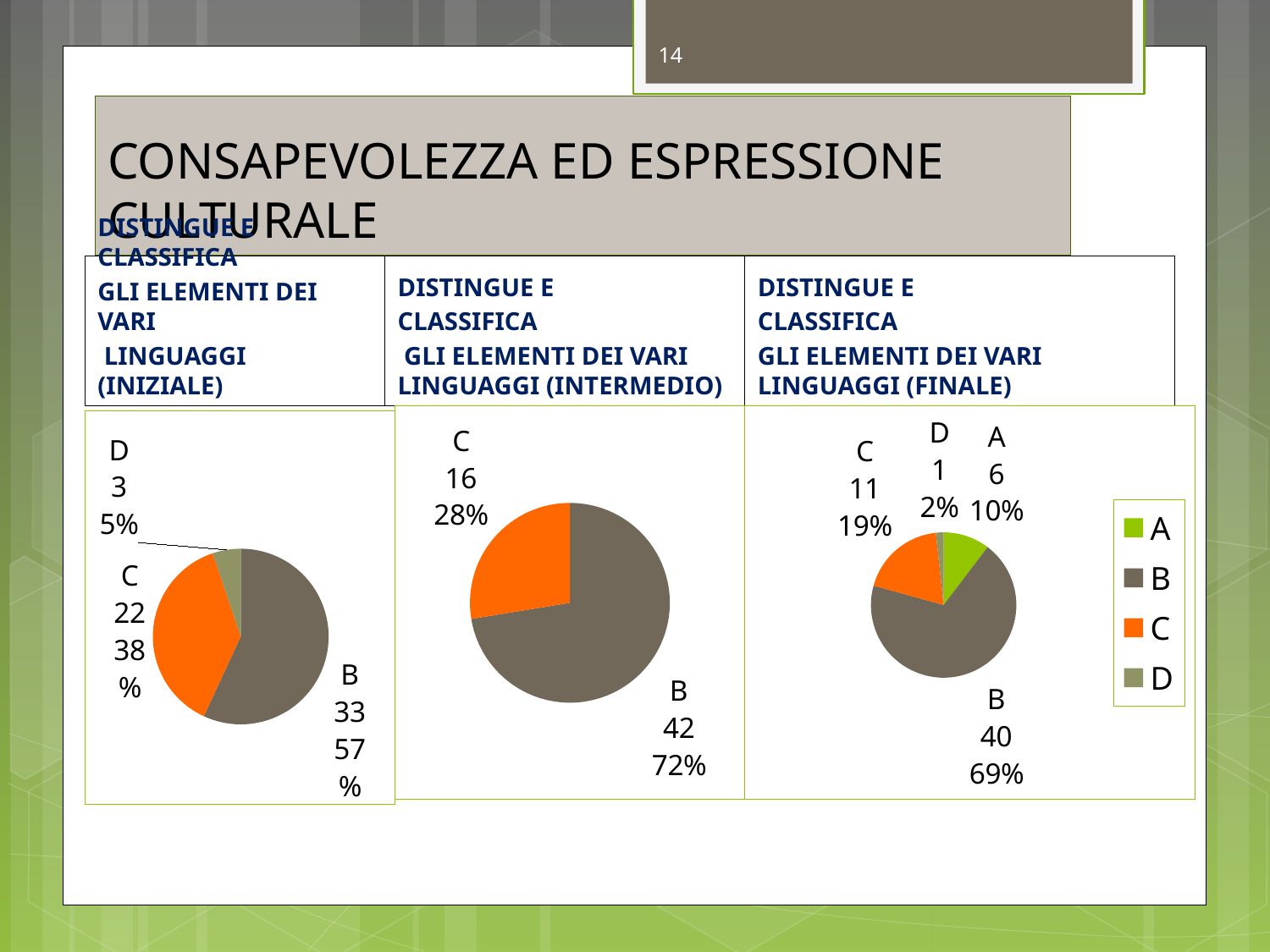
In the middle pie chart (INTERMEDIO), what is the difference between the values for B and C? 26 In the left pie chart (INIZIALE), which category has the smallest value? D In the left pie chart (INIZIALE), what percentage share does category C have? 38% What type of chart is used in the three charts on this slide? Pie chart In the right pie chart (FINALE), which is larger, the value for C or the value for A? C In the middle pie chart (INTERMEDIO), what is the value for category C? 16 In the left pie chart (INIZIALE), what is the value for category B? 33 In the middle pie chart (INTERMEDIO), what percentage share does category B have? 72% In the right pie chart (FINALE), what is the value for category A? 6 How many entries does the legend on the right of the slide list? 4 In the middle pie chart (INTERMEDIO), how many slices does the pie have? 2 In the right pie chart (FINALE), which category has the largest value? B